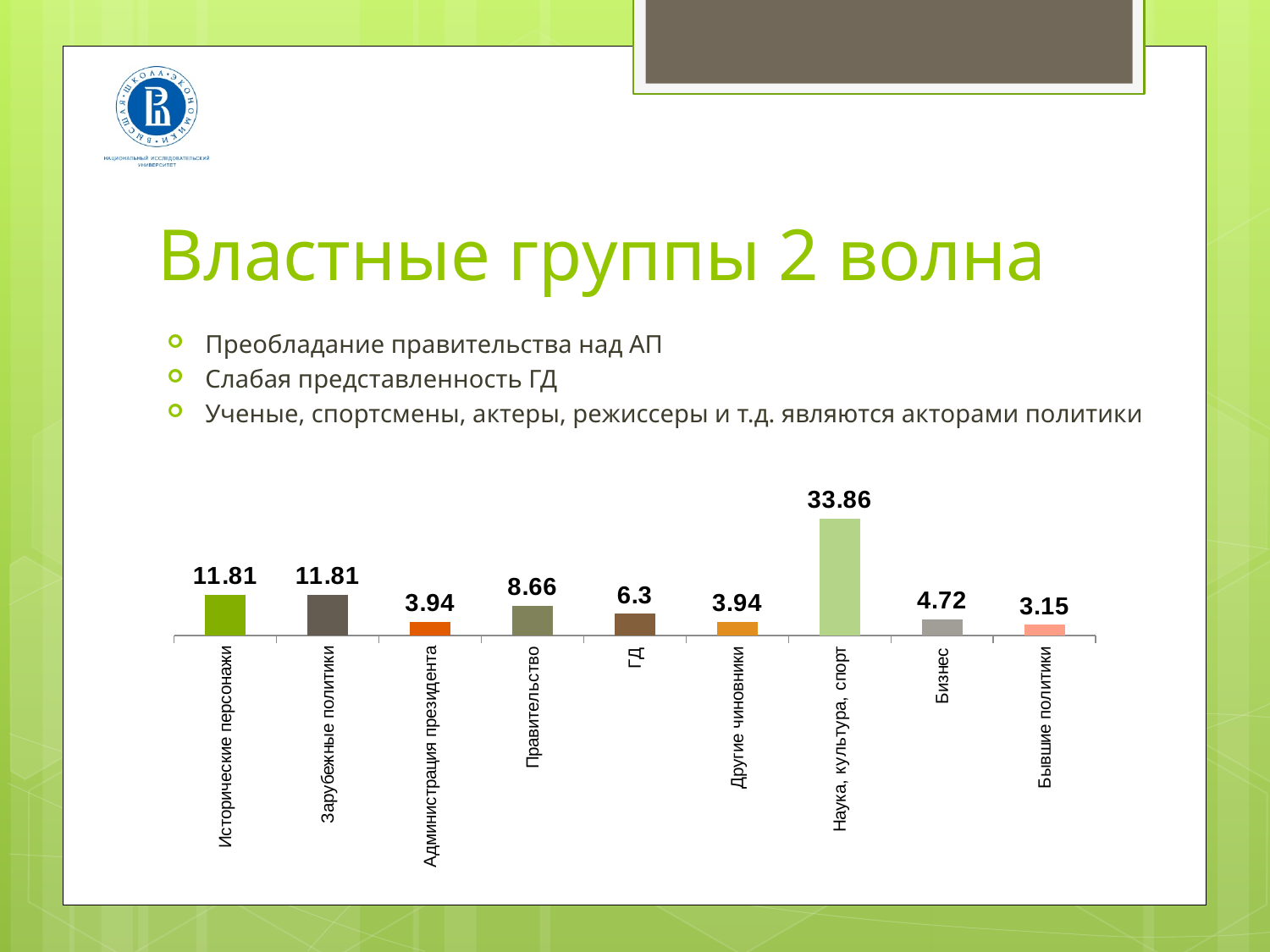
What is the difference between the values for Правительство and Администрация президента? 4.72 What kind of chart is shown on the slide? Bar chart What is the difference between the values for Наука, культура, спорт and Зарубежные политики? 22.05 Which is larger, the value for Правительство or the value for ГД? Правительство Which category has the highest value? Наука, культура, спорт Which is larger, the value for Бизнес or the value for Бывшие политики? Бизнес Which category has the lowest value? Бывшие политики What is the value for ГД? 6.3 What is the value for Бизнес? 4.72 What is the value for Наука, культура, спорт? 33.86 How many categories are shown in the chart? 9 What is the value for Правительство? 8.66